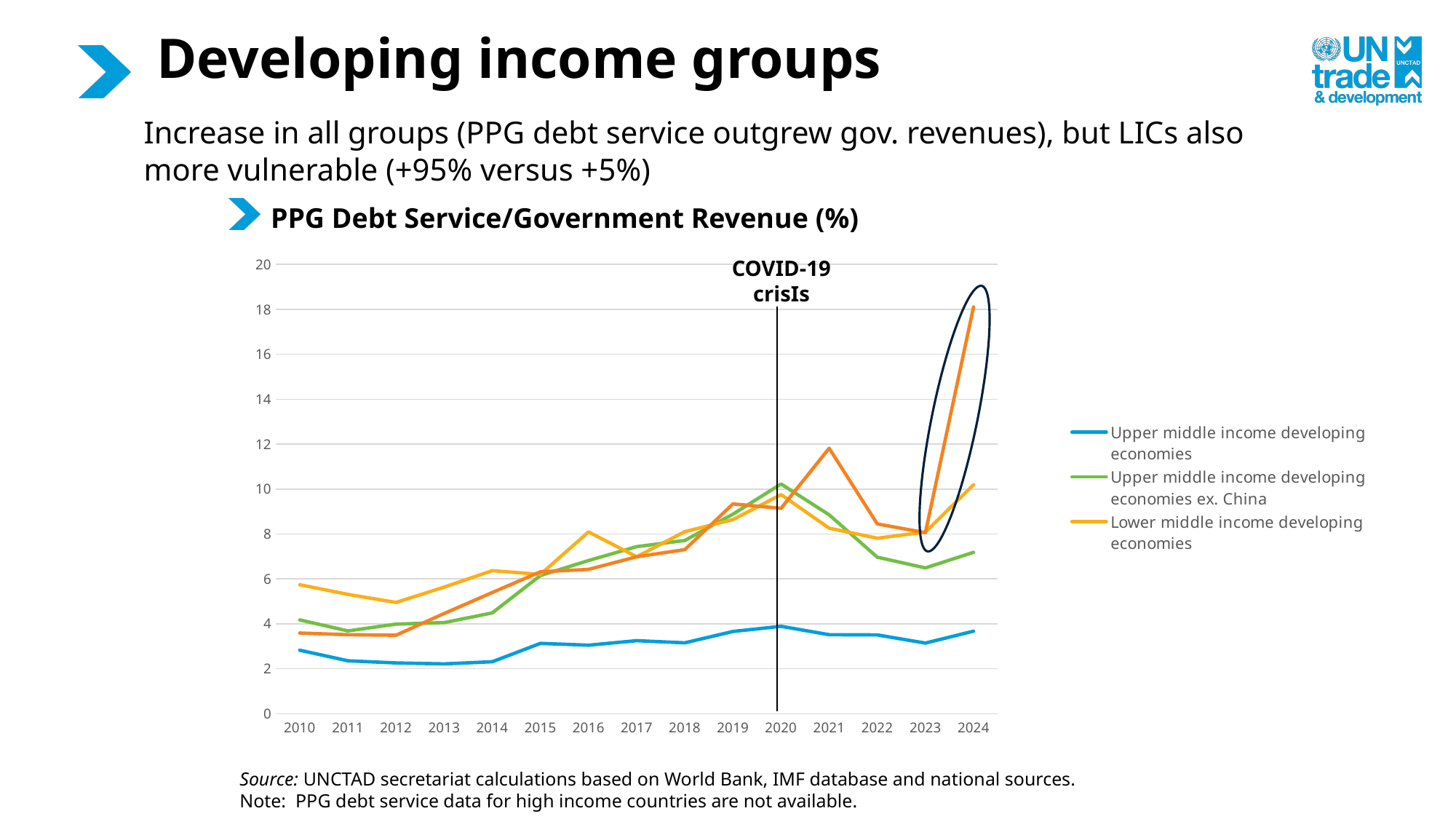
In which year does the Upper middle income developing economies ex. China series reach its highest value? 2020 Is the value for Upper middle income developing economies ex. China in 2022 greater or less than 8? less Is the value for Lower middle income developing economies in 2012 greater or less than 6? less How many years are shown on the x axis? 15 Is the value for Upper middle income developing economies ex. China in 2023 greater or less than 6? greater What event is marked by the vertical line at 2020? COVID-19 crisis What kind of chart is shown on the slide? line chart In 2024, which is higher: Upper middle income developing economies or Lower middle income developing economies? Lower middle income developing economies How many series does the legend list? 3 Does the Upper middle income developing economies series rise or fall overall from 2010 to 2020? rise